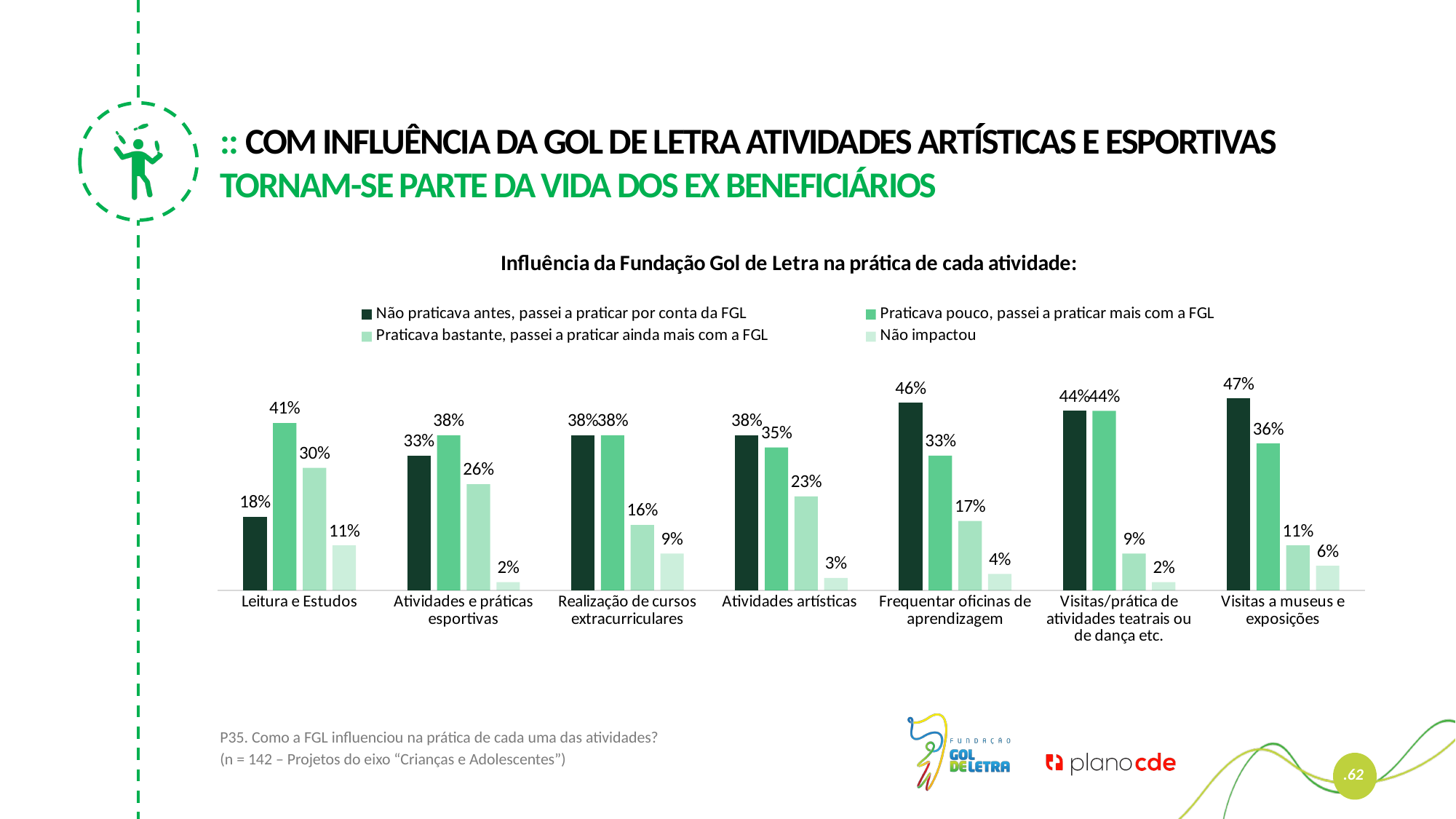
What kind of chart is shown on the slide? Bar chart For Leitura e Estudos, which is larger: "Praticava pouco, passei a praticar mais com a FGL" or "Praticava bastante, passei a praticar ainda mais com a FGL"? Praticava pouco, passei a praticar mais com a FGL What is the value of "Praticava bastante, passei a praticar ainda mais com a FGL" for Atividades artísticas? 23% What is the value of "Não praticava antes, passei a praticar por conta da FGL" for Leitura e Estudos? 18% How many series does the legend list? 4 Which category has the highest value for "Não praticava antes, passei a praticar por conta da FGL"? Visitas a museus e exposições Which category has the lowest value for "Não praticava antes, passei a praticar por conta da FGL"? Leitura e Estudos What is the title of the chart? Influência da Fundação Gol de Letra na prática de cada atividade: What is the value of "Praticava pouco, passei a praticar mais com a FGL" for Visitas a museus e exposições? 36% What is the difference between the "Não praticava antes" value and the "Praticava pouco" value for Frequentar oficinas de aprendizagem? 13% What is the value of "Não impactou" for Atividades e práticas esportivas? 2% How many activity categories are shown on the x axis? 7